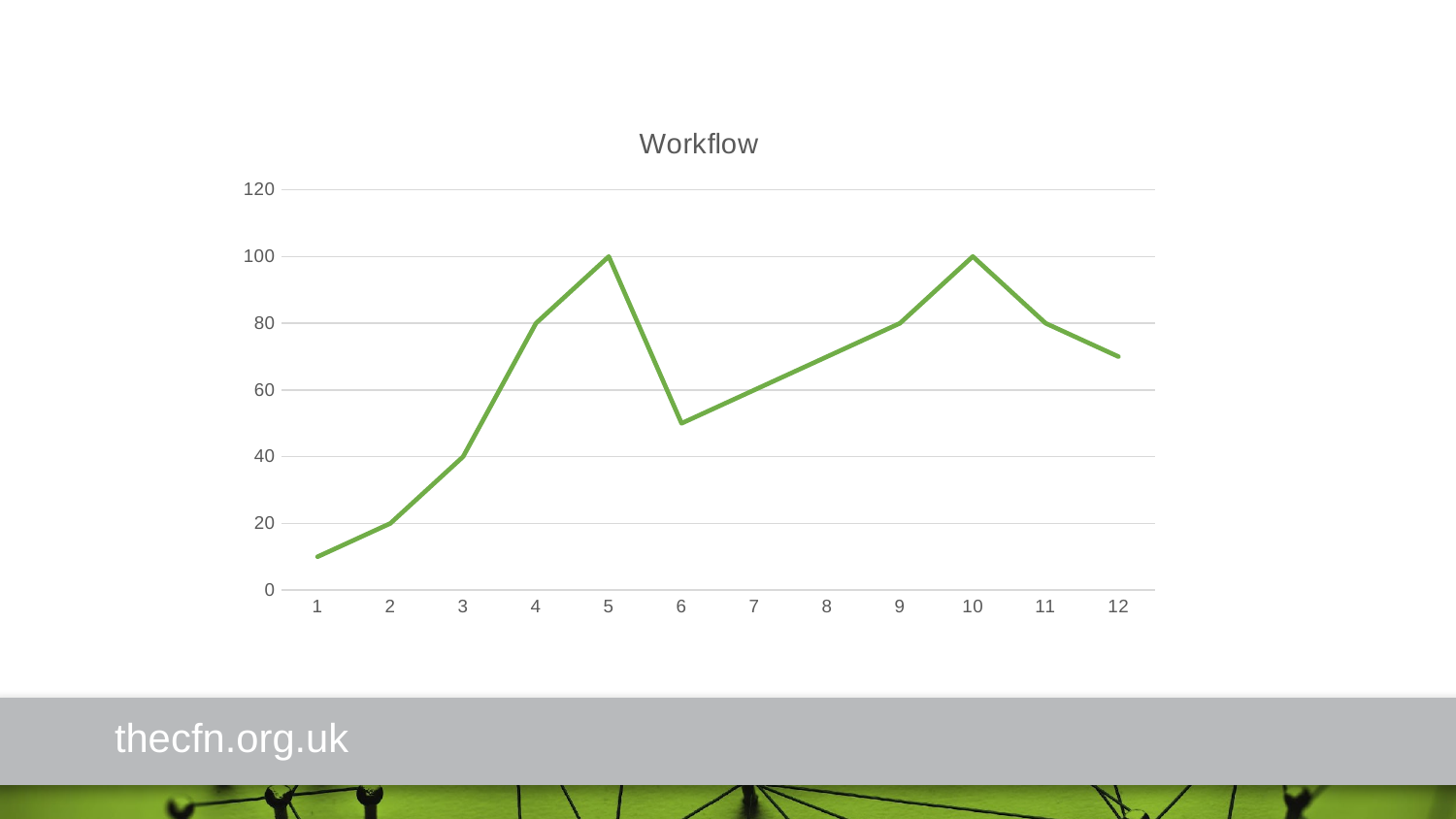
What is the value at x = 11? 80 Is the value at x = 6 greater or less than 60? less What is the value at x = 5? 100 How many points are plotted along the x axis? 12 Which is larger, the value at x = 4 or the value at x = 6? x = 4 What is the value at x = 3? 40 Is the value at x = 12 greater or less than 60? greater What is the difference between the values at x = 5 and x = 7? 40 Which x value has the lowest value on the chart? 1 What kind of chart is shown on the slide? line chart What is the value at x = 7? 60 What is the title of the chart? Workflow